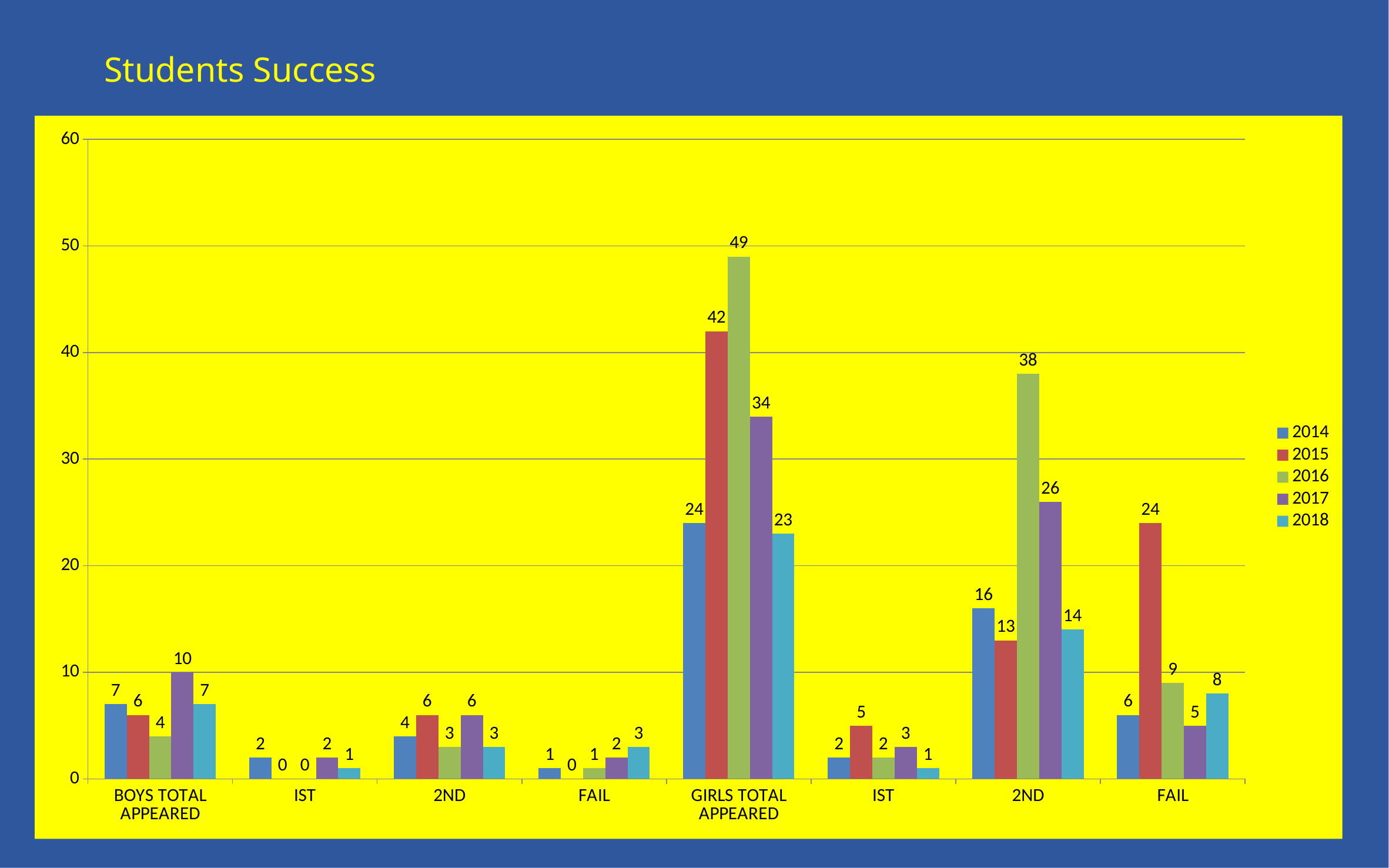
Which year has the highest value in the GIRLS TOTAL APPEARED category? 2016 What is the title of the slide? Students Success How many series does the legend list? 5 Which year has the lowest value in the GIRLS TOTAL APPEARED category? 2018 How many categories are shown on the x axis? 8 In the 2ND category to the right of GIRLS TOTAL APPEARED, which is larger: the 2016 value or the 2017 value? 2016 What is the value for 2017 in the BOYS TOTAL APPEARED category? 10 Is the 2015 value for GIRLS TOTAL APPEARED greater or less than 40? greater What kind of chart is shown on the slide? bar chart What is the value for 2015 in the FAIL category on the far right of the chart (the girls' FAIL)? 24 What is the value for 2016 in the GIRLS TOTAL APPEARED category? 49 What is the difference between the 2016 and 2015 values in the GIRLS TOTAL APPEARED category? 7